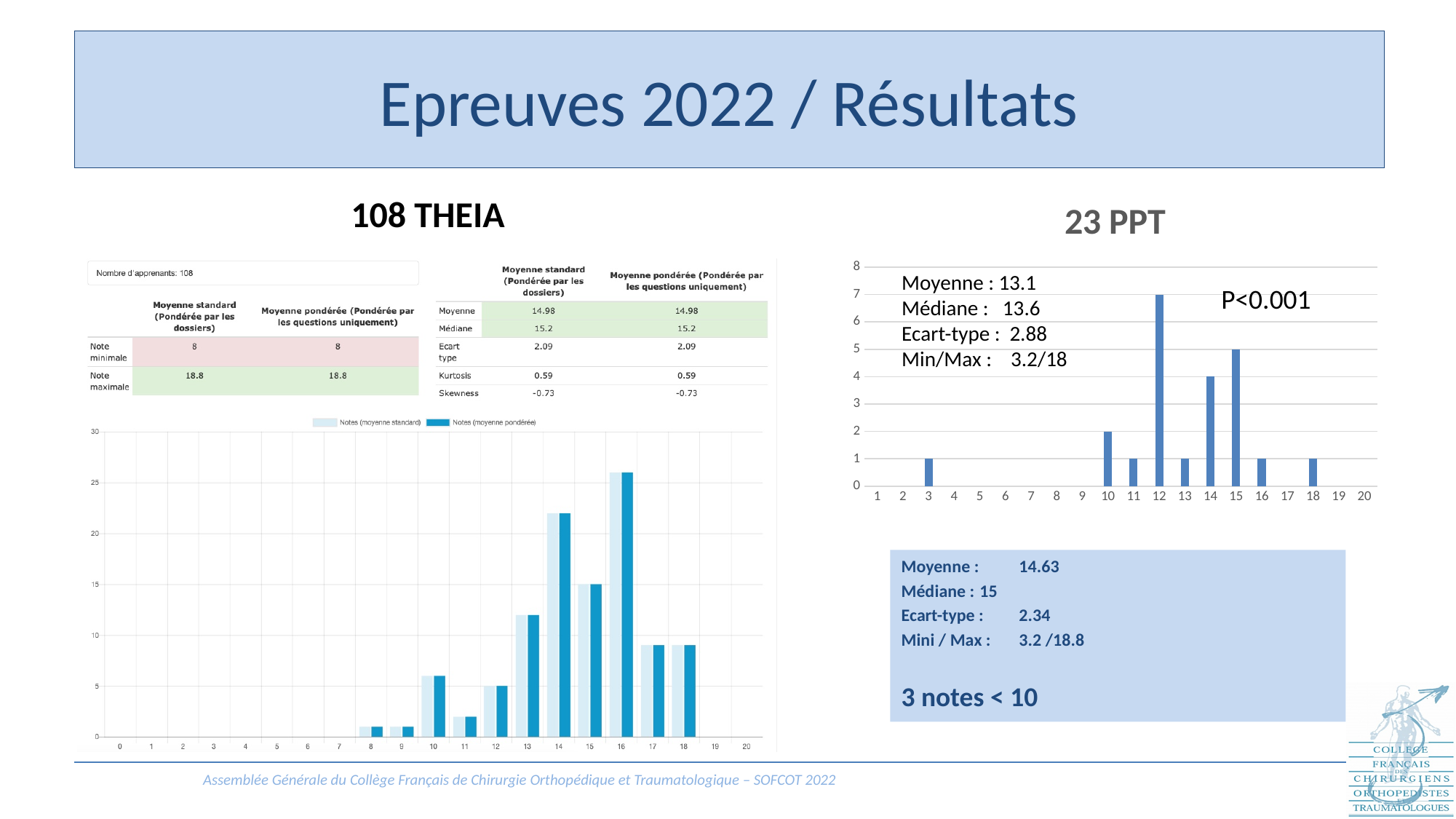
On the 23 PPT chart, how many candidates obtained a score of 12? 7 On the 108 THEIA chart, is the value for score 16 greater or less than 25? greater On the 23 PPT chart, how many candidates obtained a score of 14? 4 On the 23 PPT chart, which score has the highest number of candidates? 12 On the 23 PPT chart, how many scores have at least one candidate? 9 On the 108 THEIA chart, which score has the highest number of candidates? 16 On the 23 PPT chart, what is the difference between the number of candidates with a score of 12 and those with a score of 15? 2 What kind of chart is the 23 PPT chart? bar chart On the 23 PPT chart, which has more candidates: a score of 10 or a score of 14? 14 How many series does the legend of the 108 THEIA chart list? 2 On the 108 THEIA chart, is the value for score 17 greater or less than 10? less On the 23 PPT chart, how many candidates obtained a score of 15? 5